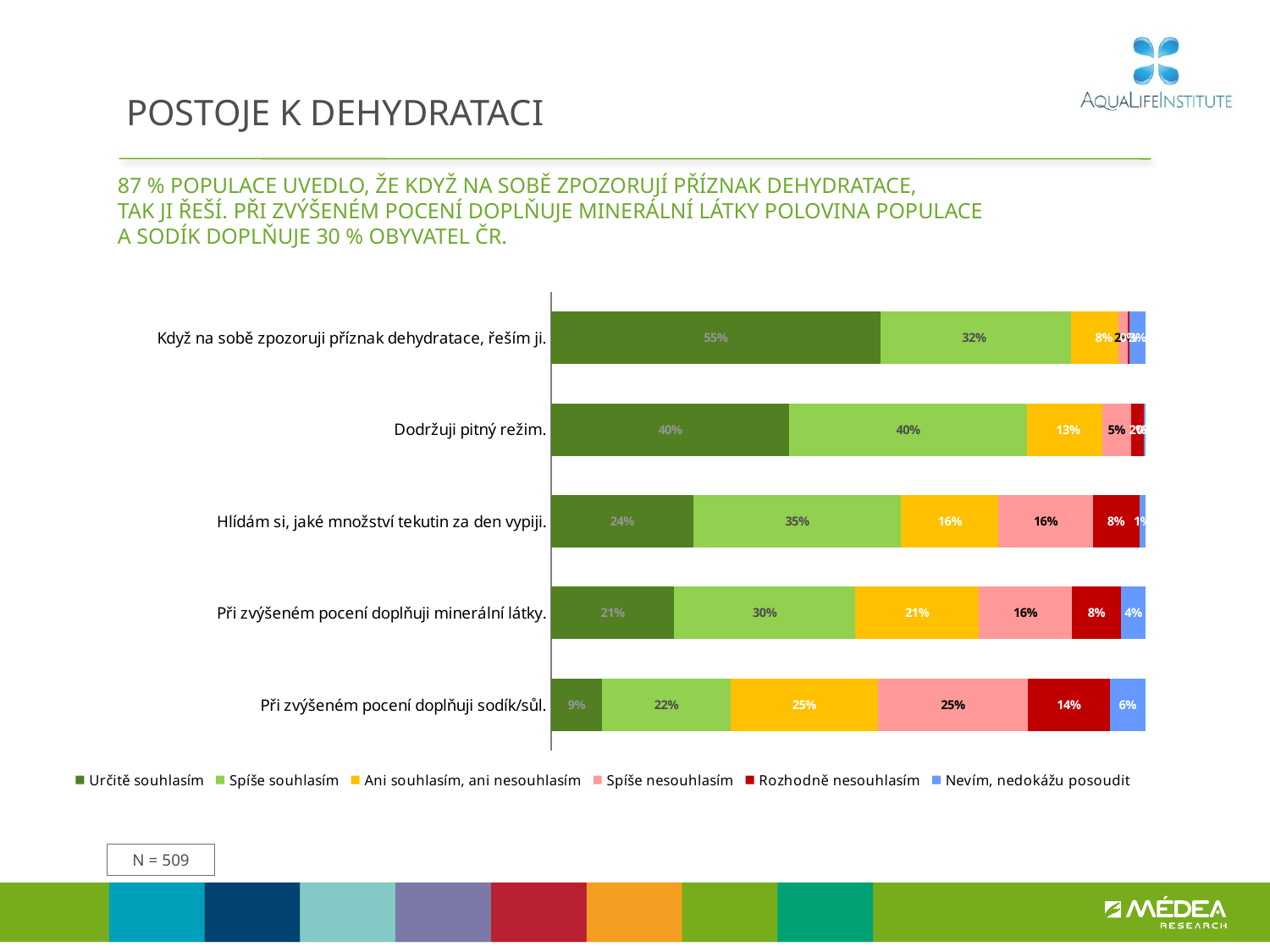
What kind of chart is shown on the slide? Stacked bar chart What is the 'Nevím, nedokážu posoudit' value for 'Při zvýšeném pocení doplňuji minerální látky.'? 4% Which statement has the lowest 'Určitě souhlasím' value? Při zvýšeném pocení doplňuji sodík/sůl. What is the difference between the 'Rozhodně nesouhlasím' values for 'Při zvýšeném pocení doplňuji sodík/sůl.' and 'Hlídám si, jaké množství tekutin za den vypiji.'? 6% Which is larger: the 'Spíše souhlasím' value for 'Hlídám si, jaké množství tekutin za den vypiji.' or for 'Při zvýšeném pocení doplňuji minerální látky.'? Hlídám si, jaké množství tekutin za den vypiji. What is the 'Spíše souhlasím' value for 'Dodržuji pitný režim.'? 40% What is the 'Spíše nesouhlasím' value for 'Při zvýšeném pocení doplňuji sodík/sůl.'? 25% How many statements (categories) are plotted in the chart? 5 What is the sample size shown below the chart? N = 509 How many series does the legend list? 6 What is the 'Určitě souhlasím' value for 'Když na sobě zpozoruji příznak dehydratace, řeším ji.'? 55% Which statement has the highest 'Určitě souhlasím' value? Když na sobě zpozoruji příznak dehydratace, řeším ji.